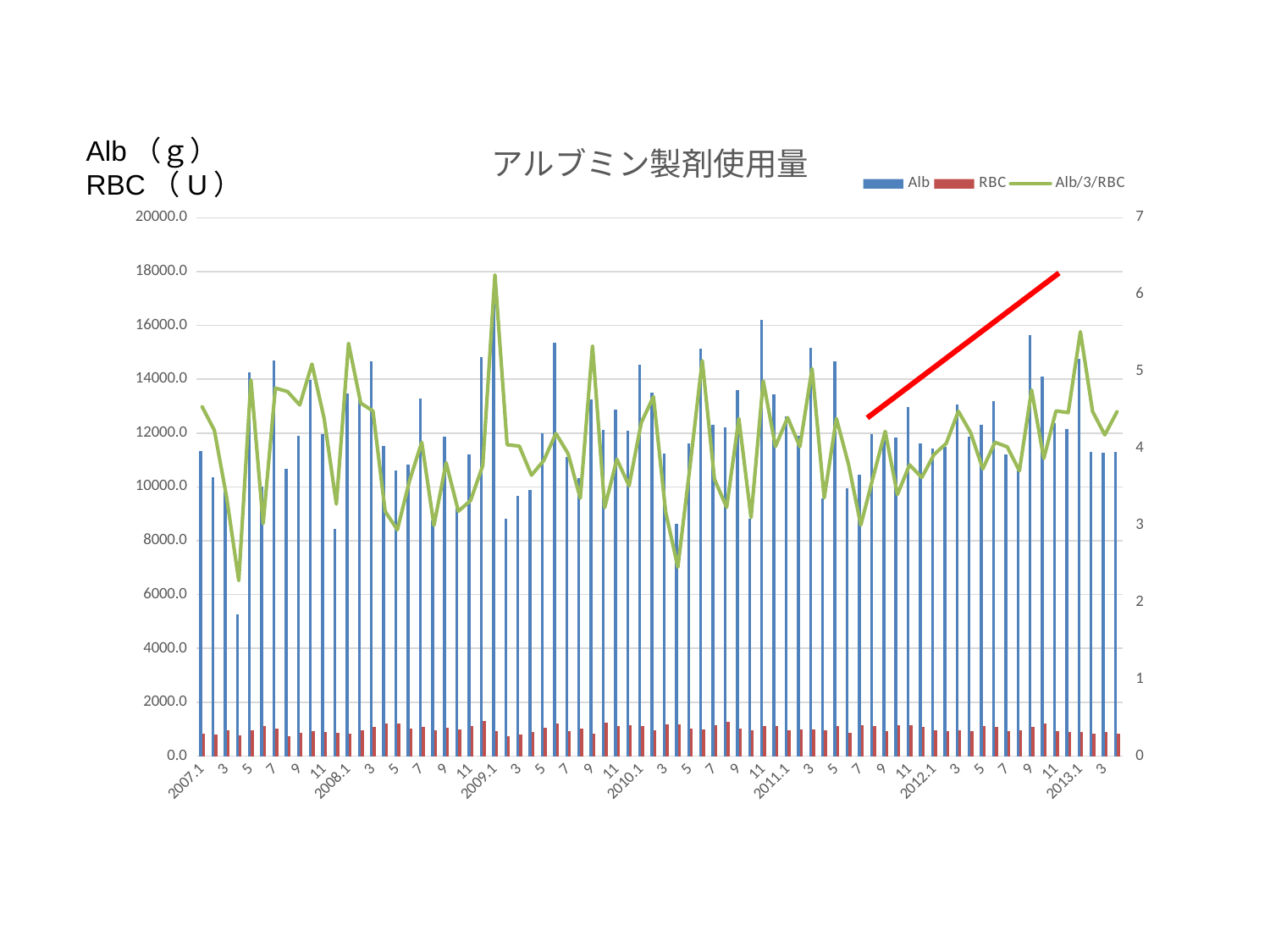
Is the RBC value at 2007.1 greater or less than 2000.0? less What is the maximum value shown on the left vertical axis? 20000.0 Is the Alb value at 2007.1 greater or less than 10000.0? greater What is the title of the chart? アルブミン製剤使用量 What are the series names listed in the legend? Alb, RBC, Alb/3/RBC At which x-axis label does the Alb bar reach its highest value? 2009.1 Is the Alb/3/RBC value at 2009.1 greater or less than 5 on the right axis? greater How many series does the chart legend list? 3 At which x-axis label does the Alb/3/RBC line reach its highest point? 2009.1 What kind of chart is this? Combination bar and line chart